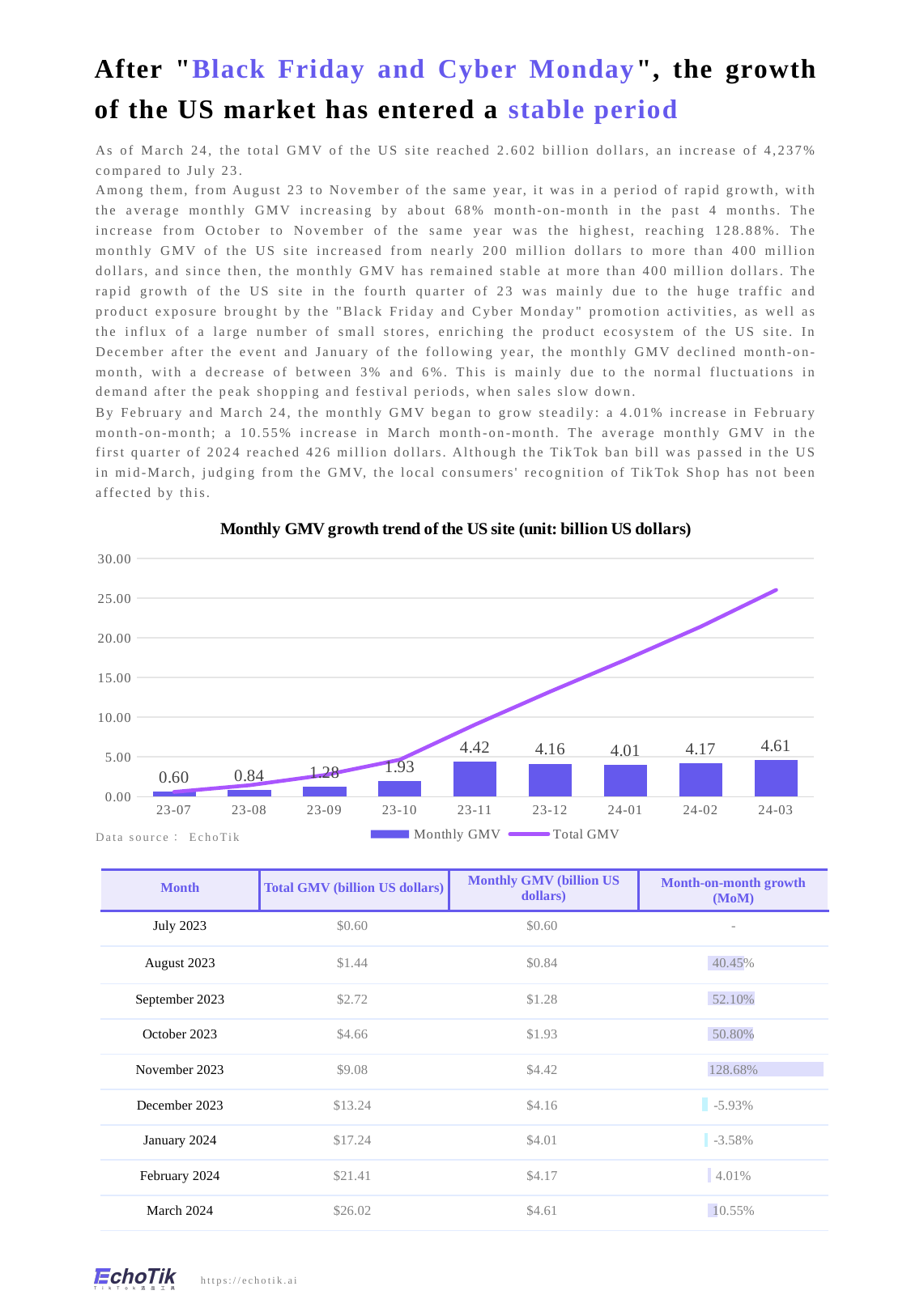
Is the Total GMV line value for 24-03 greater or less than 25.00? greater What kind of chart is used to show Monthly GMV? Bar chart What is the title of the chart? Monthly GMV growth trend of the US site (unit: billion US dollars) How many months are shown on the x axis of the chart? 9 What is the difference between the Monthly GMV for 24-03 and 24-02? 0.44 What is the Monthly GMV value for 23-11 in the chart? 4.42 What is the Monthly GMV value for 23-07 in the chart? 0.60 Which month has the highest Monthly GMV bar in the chart? 24-03 Is the Total GMV line value for 23-12 greater or less than 15.00? less Which month has the lowest Monthly GMV bar in the chart? 23-07 How many series does the chart legend list? 2 Which is larger, the Monthly GMV for 23-10 or for 23-11? 23-11